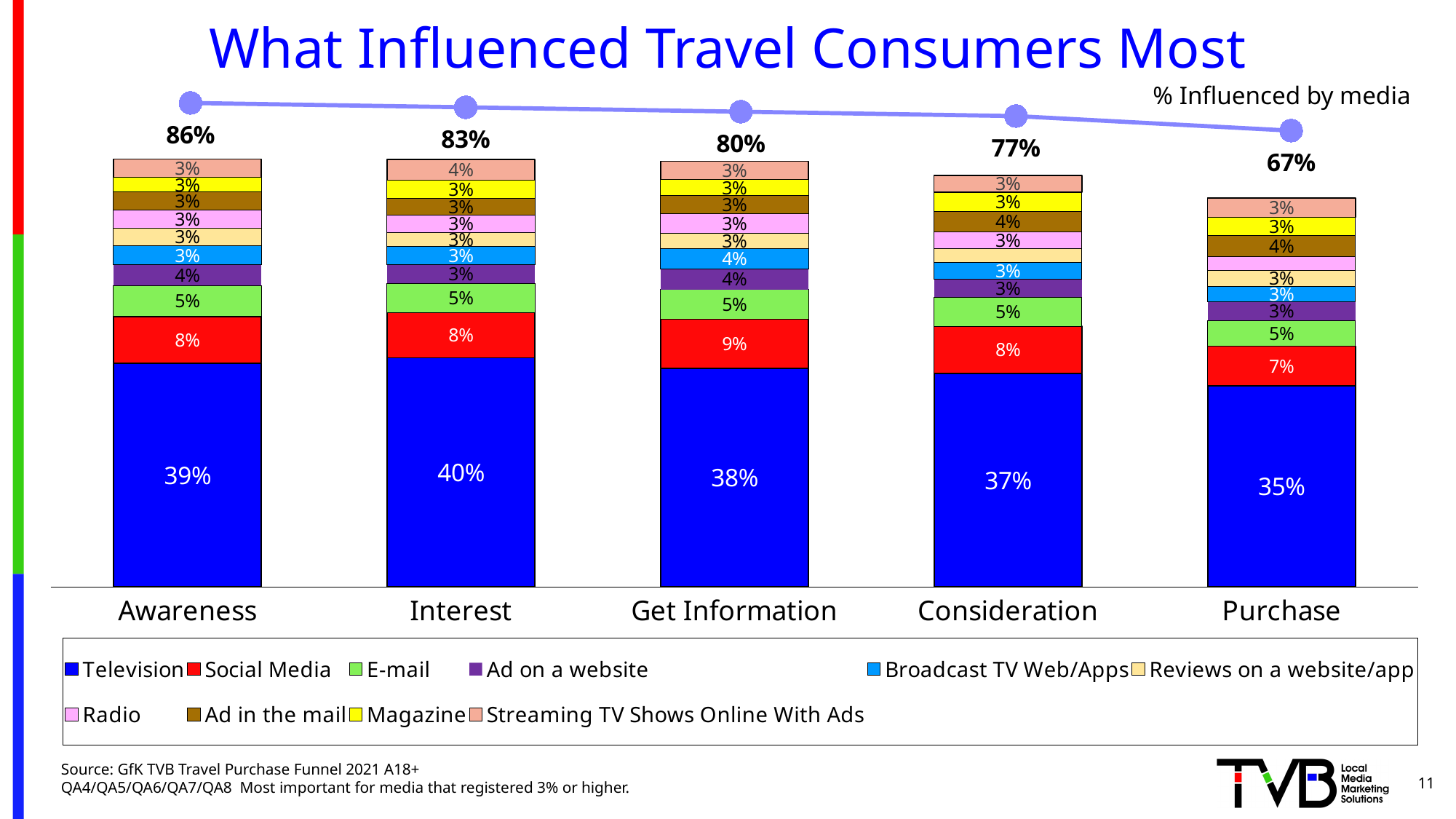
What is the difference between the % Influenced by media value for Awareness and for Purchase? 19 percentage points What is the Social Media value for the Get Information stage? 9% Which stage has the highest % Influenced by media value? Awareness How many series does the legend list? 10 Which stage has the lowest Television value? Purchase Which is larger, the Social Media value for Get Information or for Purchase? Get Information How many stages are shown along the x axis? 5 What is the Television value for the Interest stage? 40% Does the % Influenced by media line rise or fall from Awareness to Purchase? Falls What is the Ad in the mail value for the Consideration stage? 4% What is the difference between the Television value for Awareness and the Television value for Purchase? 4 percentage points What is the % Influenced by media value for the Purchase stage? 67%